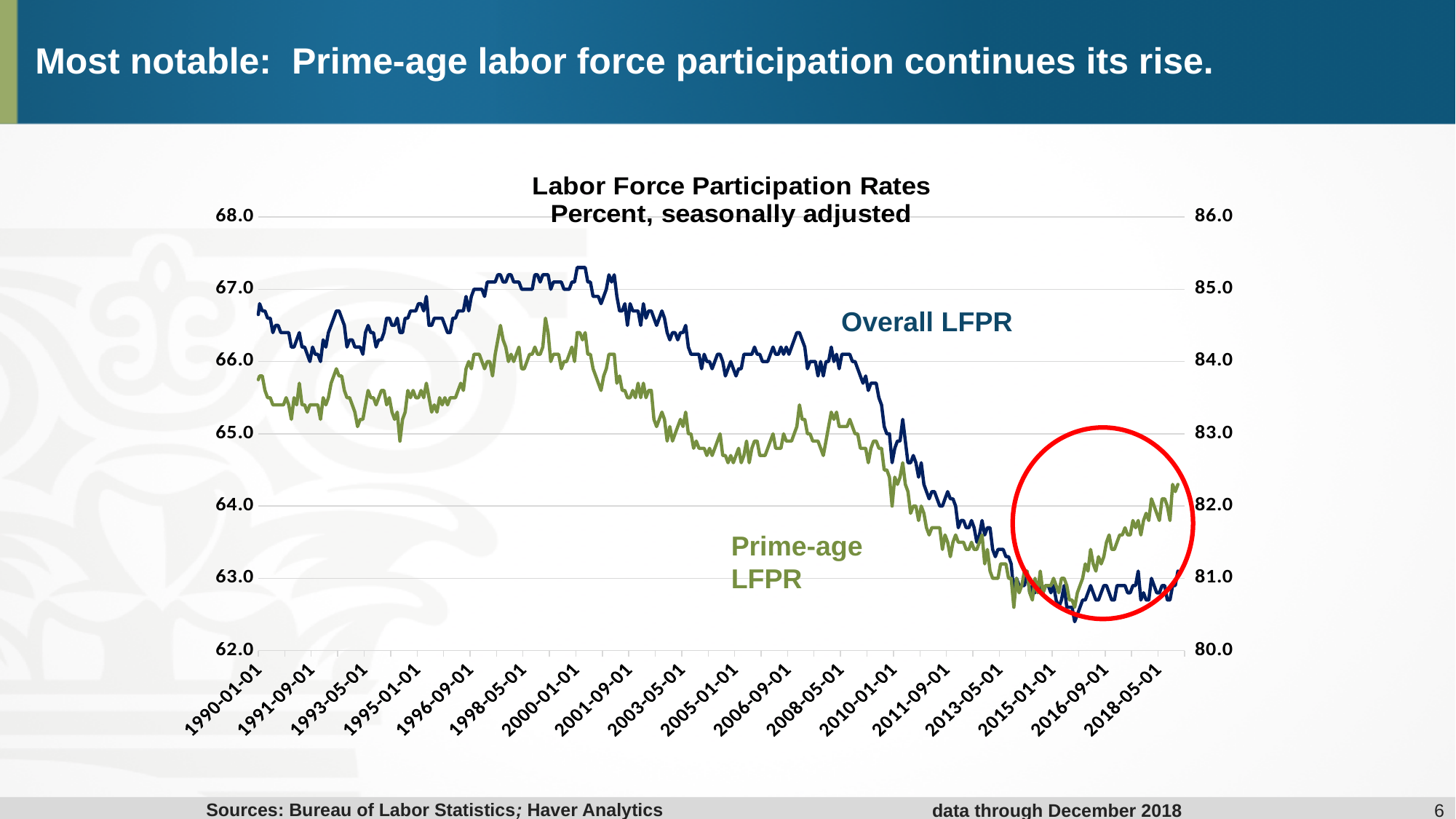
Is the Prime-age LFPR at the end of the series in 2018 greater or less than 81.0 on the right axis? greater Does the Prime-age LFPR rise or fall between 2015-01-01 and 2018-05-01? Rise Is the Prime-age LFPR at its peak around 2000-01-01 greater or less than 84.0 on the right axis? greater Does the Overall LFPR rise or fall between 1993-05-01 and 1998-05-01? Rise Is the lowest point of the Overall LFPR, around 2015-2016, greater or less than 63.0 on the left axis? less Which series is drawn in green? Prime-age LFPR How many series are plotted on the chart? 2 What is the title of the chart? Labor Force Participation Rates What kind of chart is shown on the slide? Line chart Does the Overall LFPR rise or fall between 2010-01-01 and 2015-01-01? Fall